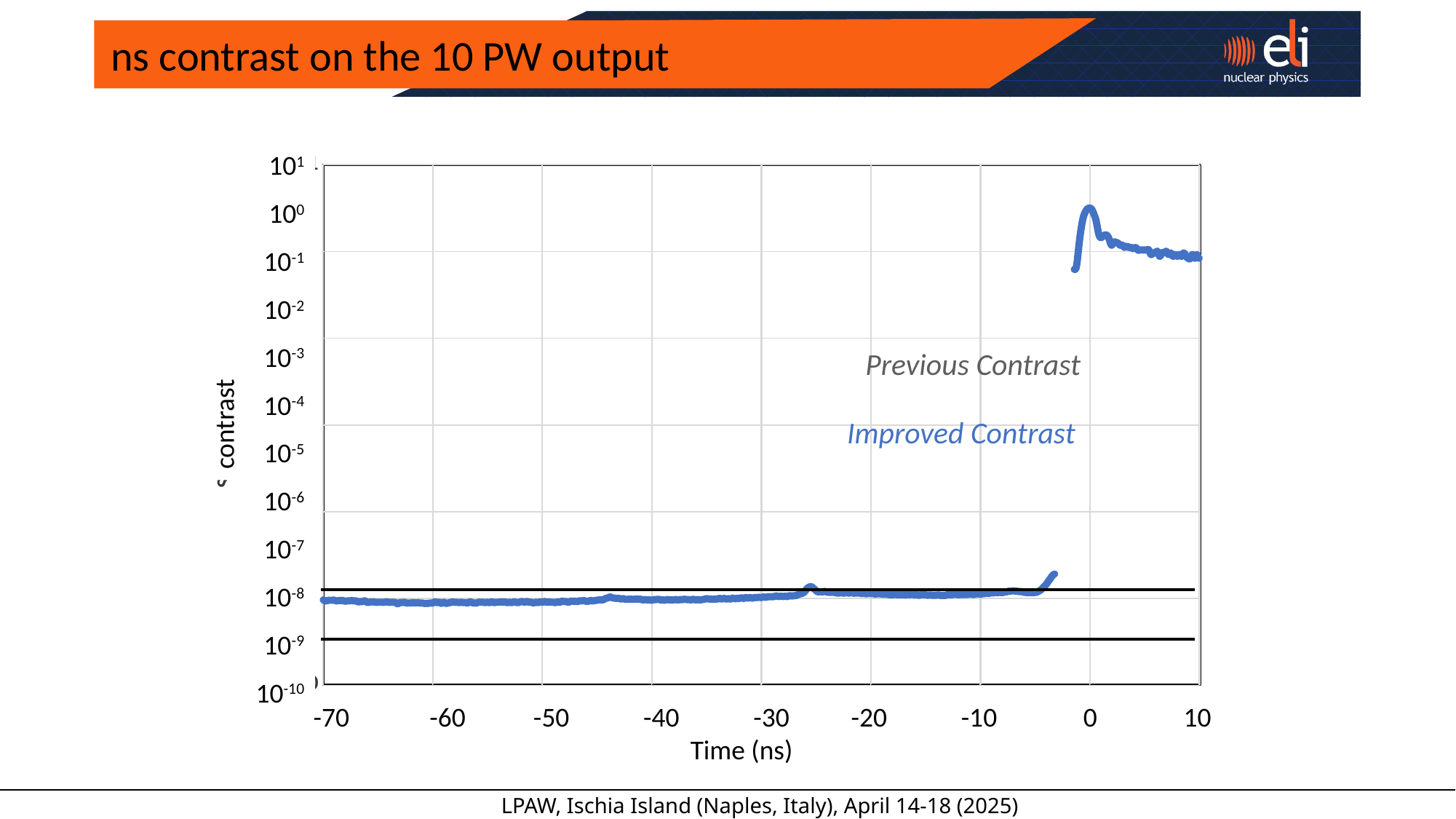
What is the label of the x axis of the chart? Time (ns) What kind of chart is shown on the slide? line chart What is the title of the slide containing the chart? ns contrast on the 10 PW output Is the peak value of the blue curve near 0 ns greater or less than 10^-1? greater At which x-axis tick does the blue curve reach its highest value? 0 What is the lowest value labelled on the y axis? 10^-10 Is the value of the blue curve at 10 ns greater or less than 10^0? less Does the blue curve rise or fall between 0 ns and 10 ns? fall How many tick labels are shown on the x axis? 9 Is the value of the blue curve at -30 ns greater or less than 10^-6? less